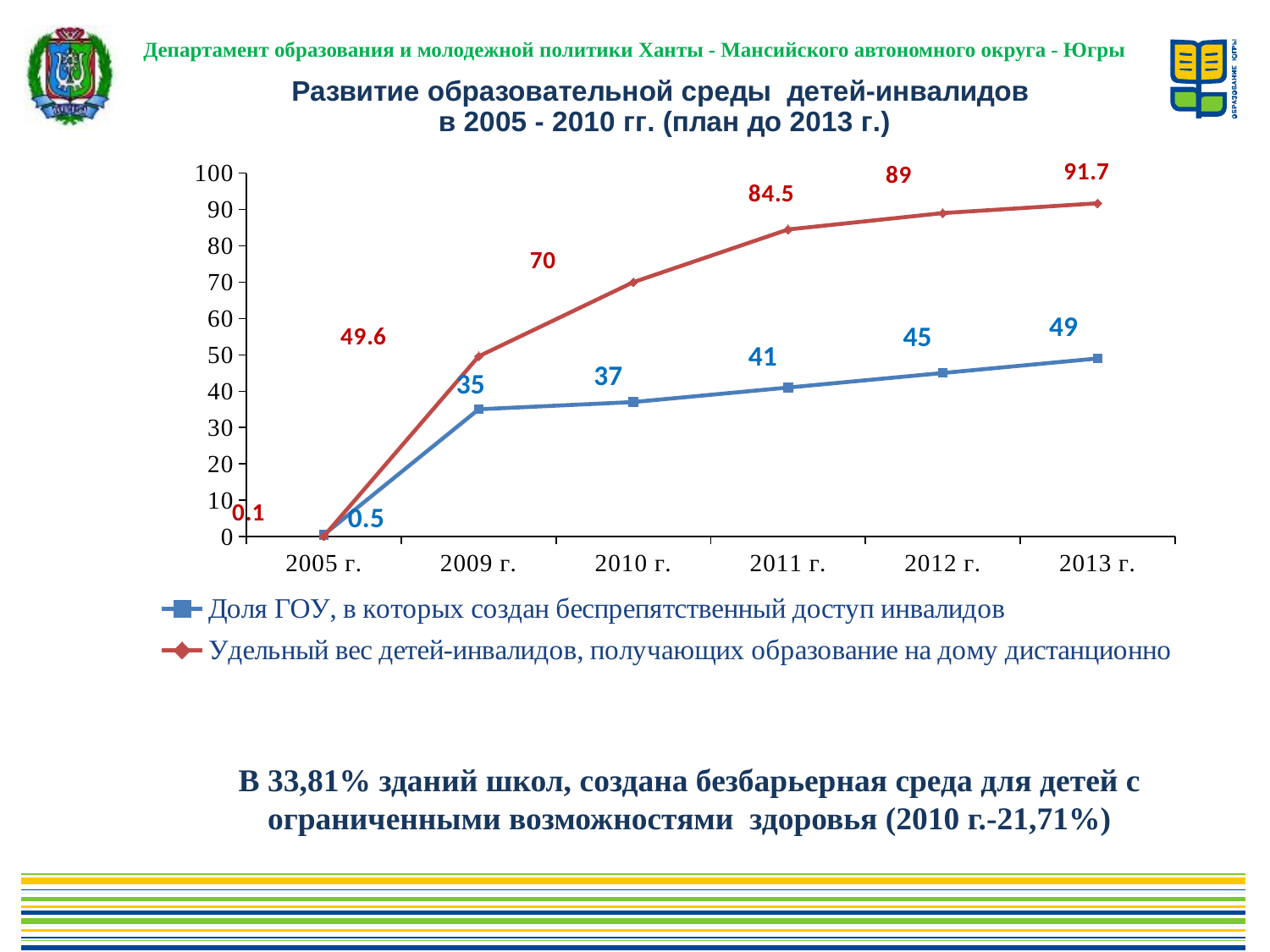
How many years are shown on the x axis? 6 Does 'Доля ГОУ, в которых создан беспрепятственный доступ инвалидов' rise or fall from 2005 г. to 2013 г.? rise What is the value of 'Удельный вес детей-инвалидов, получающих образование на дому дистанционно' in 2013 г.? 91.7 What is the value of 'Удельный вес детей-инвалидов, получающих образование на дому дистанционно' in 2009 г.? 49.6 What type of chart is shown on the slide? line chart How many series does the legend list? 2 Which series has the larger value in 2010 г.? Удельный вес детей-инвалидов, получающих образование на дому дистанционно What is the difference between the two series in 2012 г.? 44 In which year is 'Удельный вес детей-инвалидов, получающих образование на дому дистанционно' highest? 2013 г. What colour is the line for 'Удельный вес детей-инвалидов, получающих образование на дому дистанционно'? red In which year is 'Доля ГОУ, в которых создан беспрепятственный доступ инвалидов' lowest? 2005 г. What is the value of 'Доля ГОУ, в которых создан беспрепятственный доступ инвалидов' in 2011 г.? 41